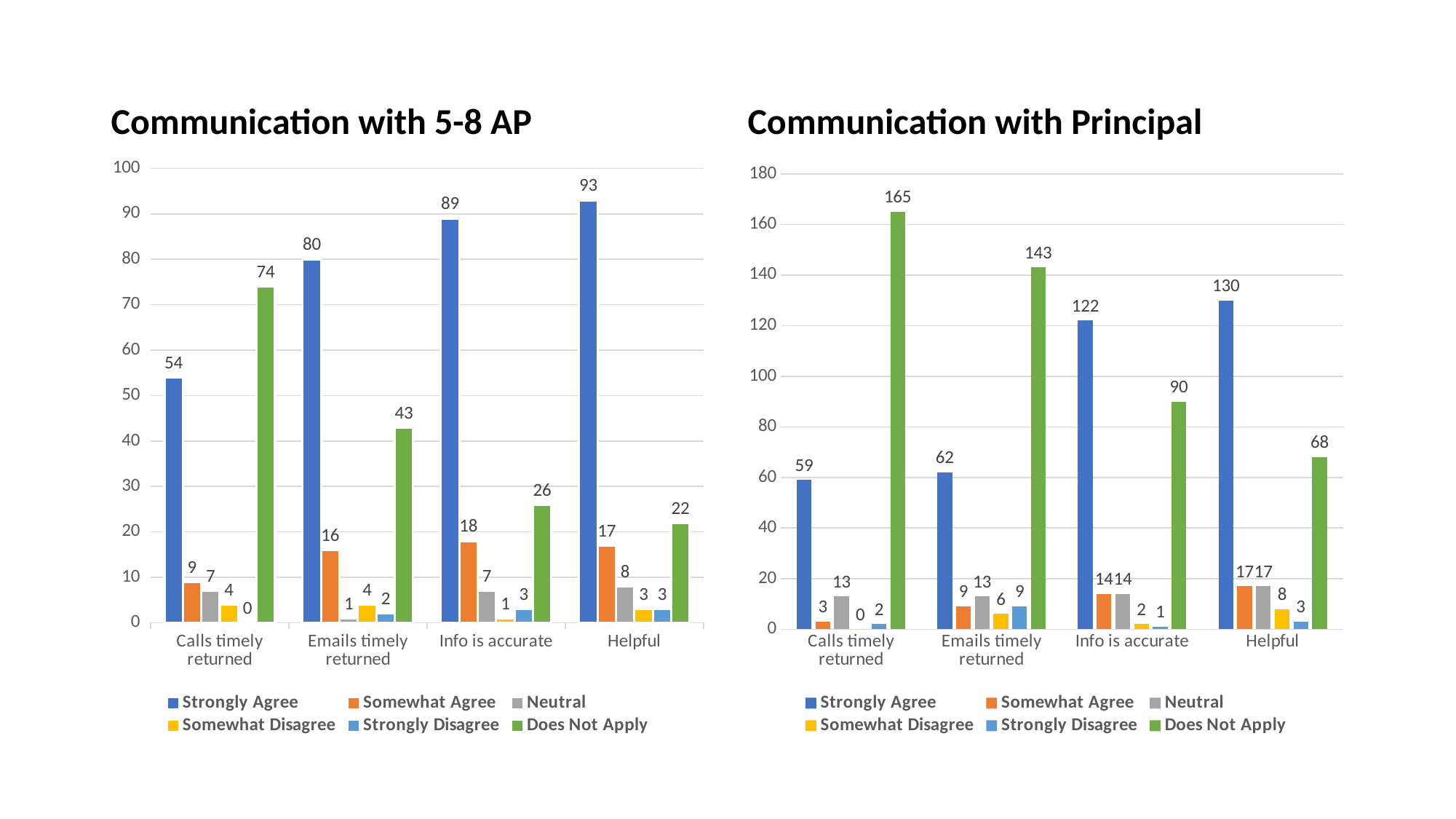
In the 'Communication with Principal' chart, what colour represents the Does Not Apply series? Green How many series does the legend of the 'Communication with Principal' chart list? 6 How many categories are shown on the x axis of the 'Communication with 5-8 AP' chart? 4 In the 'Communication with 5-8 AP' chart, do the Does Not Apply values rise or fall from left to right across the categories? Fall In the 'Communication with Principal' chart, is the Does Not Apply value for 'Emails timely returned' greater or less than 140? greater In the 'Communication with 5-8 AP' chart, what is the value for Strongly Agree on 'Helpful'? 93 What kind of chart is 'Communication with 5-8 AP'? Bar chart In the 'Communication with Principal' chart, what is the difference between the Strongly Agree values for 'Helpful' and 'Calls timely returned'? 71 In the 'Communication with Principal' chart, what is the value for Does Not Apply on 'Calls timely returned'? 165 In the 'Communication with Principal' chart, which category has the lowest Does Not Apply value? Helpful In the 'Communication with 5-8 AP' chart, which category has the highest Strongly Agree value? Helpful In the 'Communication with 5-8 AP' chart, which is larger for 'Emails timely returned': Strongly Agree or Does Not Apply? Strongly Agree